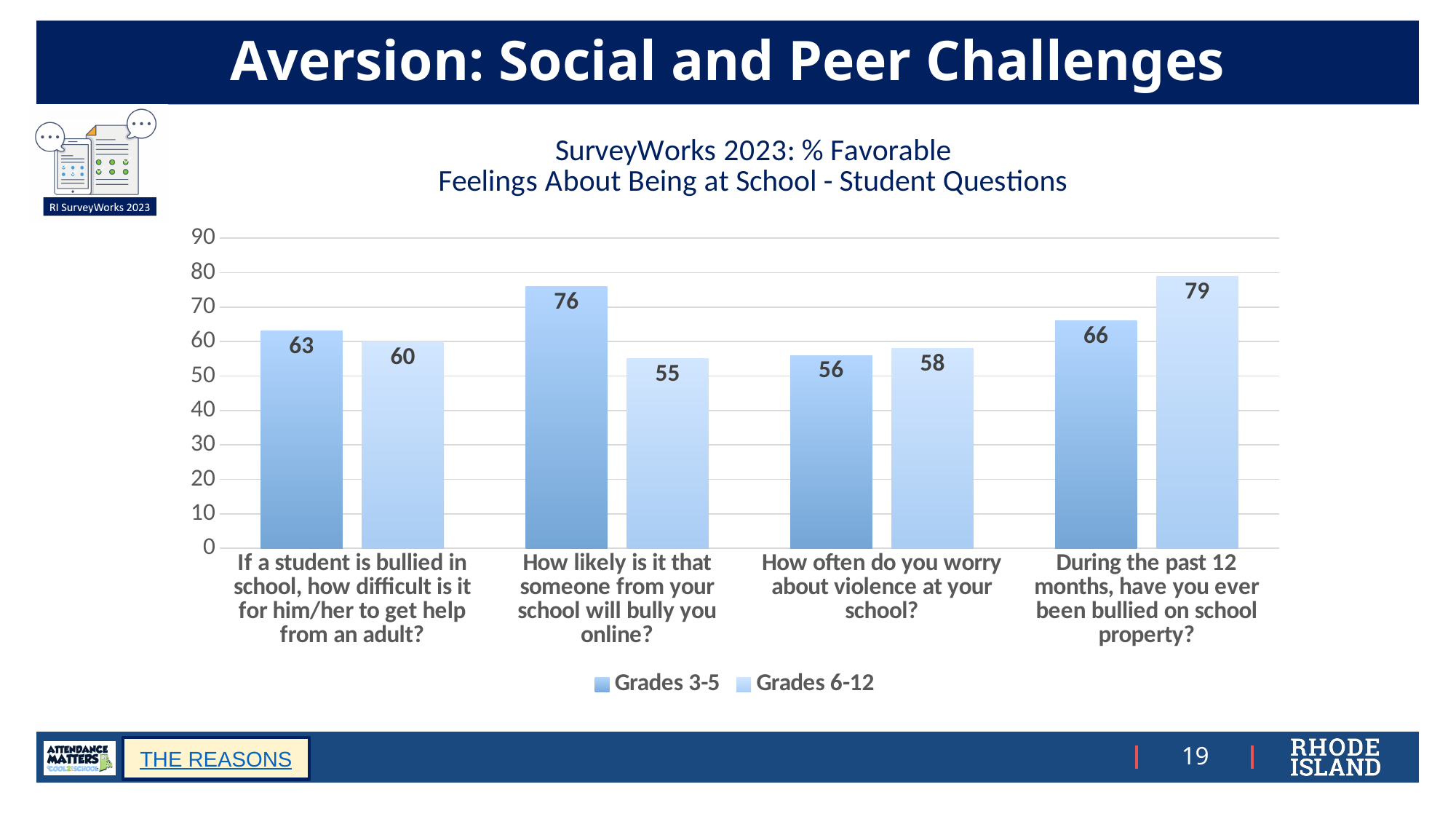
How many survey questions are shown on the x axis? 4 What is the Grades 3-5 value for "How likely is it that someone from your school will bully you online?"? 76 What is the difference between the Grades 3-5 and Grades 6-12 values for "How likely is it that someone from your school will bully you online?"? 21 What is the Grades 6-12 value for "How often do you worry about violence at your school?"? 58 Which question has the lowest Grades 6-12 value? How likely is it that someone from your school will bully you online? How many series does the legend list? 2 Which question has the highest Grades 3-5 value? How likely is it that someone from your school will bully you online? What is the Grades 6-12 value for "During the past 12 months, have you ever been bullied on school property?"? 79 Is the Grades 3-5 value for "How often do you worry about violence at your school?" greater or less than 60? less What is the title of the chart? SurveyWorks 2023: % Favorable Feelings About Being at School - Student Questions What kind of chart is shown on the slide? Bar chart For "During the past 12 months, have you ever been bullied on school property?", which group has the larger value, Grades 3-5 or Grades 6-12? Grades 6-12